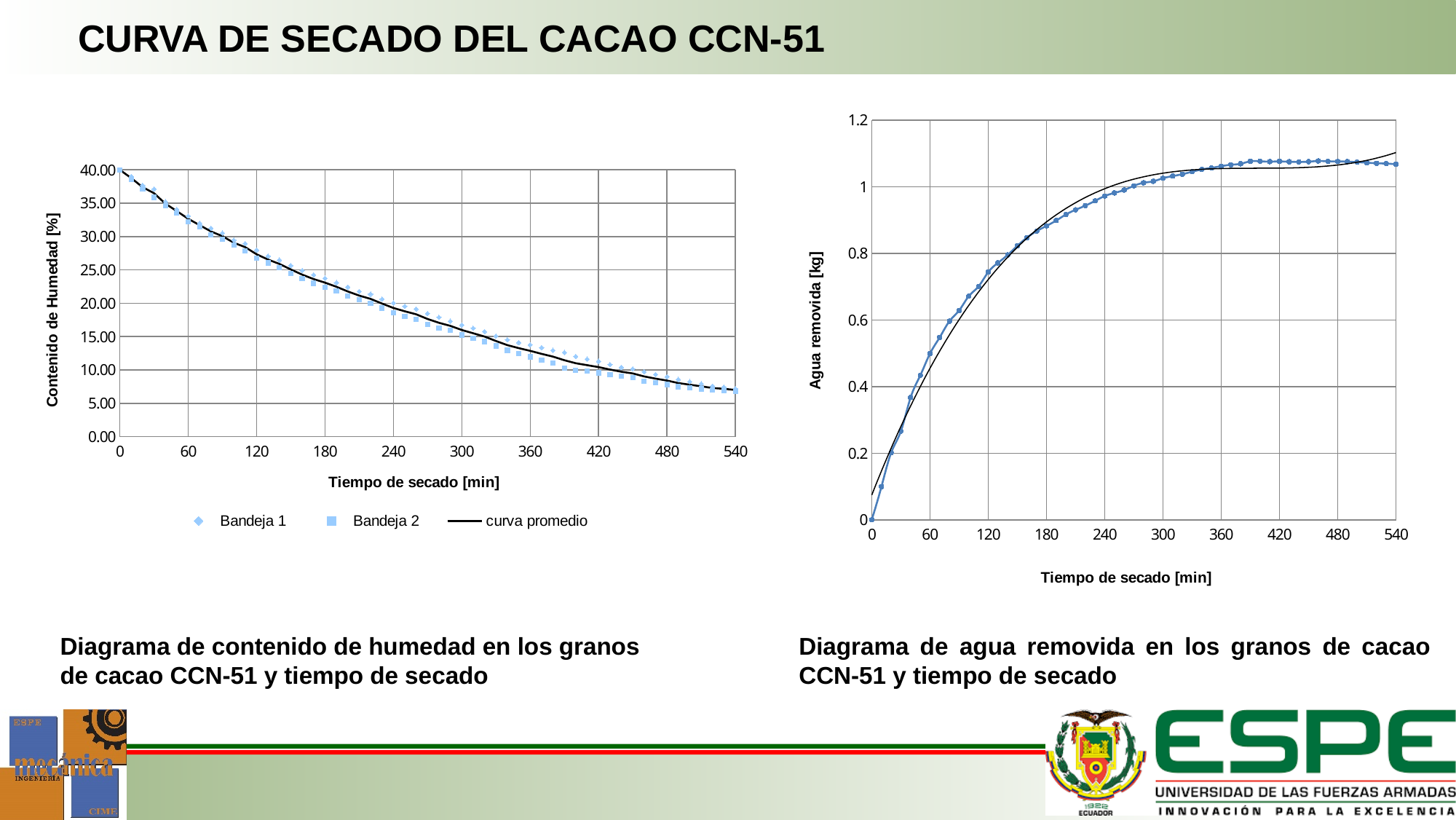
In the right chart, is the water removed at 120 min greater or less than 0.6? greater In the left chart, what is the moisture content at 0 min? 40.00 What is the y-axis title of the left chart? Contenido de Humedad [%] In the left chart, is the moisture content at 120 min greater or less than 25.00? greater What kind of chart is the left chart (Diagrama de contenido de humedad)? line chart In the right chart (Diagrama de agua removida), do the values rise or fall as drying time increases? rise In the right chart, what is the water removed at 0 min? 0 In the left chart, do the values rise or fall as drying time increases? fall In the right chart, is the water removed at 540 min greater or less than 1? greater What is the y-axis title of the right chart? Agua removida [kg] How many series does the legend of the left chart list? 3